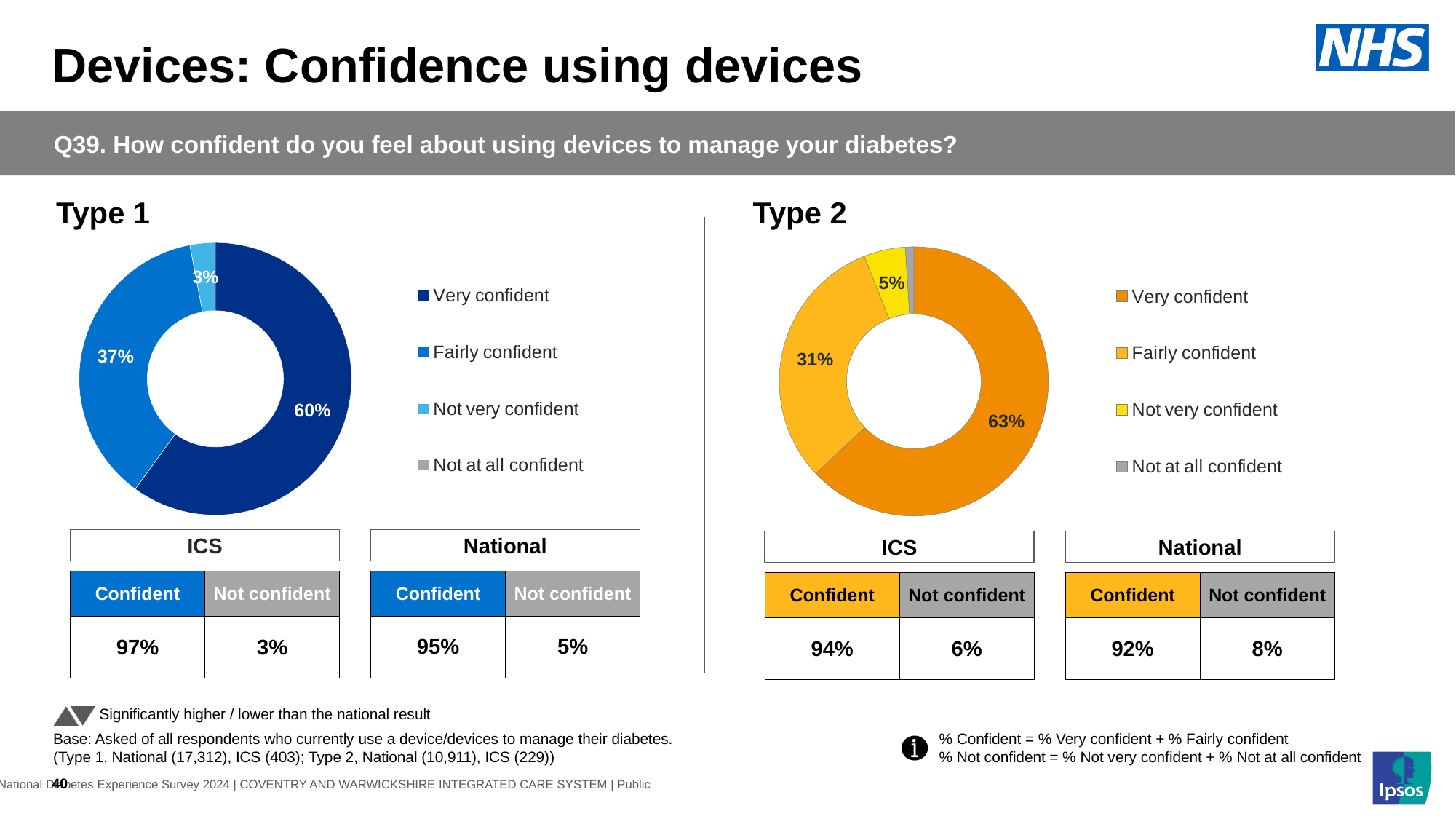
In the Type 2 chart, which category has the largest share? Very confident How many entries does the legend of the Type 2 chart list? 4 In the Type 2 chart, what percentage of respondents are not very confident? 5% What kind of chart is used for Type 1? Donut chart In the Type 1 chart, what is the difference between the very confident and fairly confident shares? 23% Is the very confident share larger in the Type 1 chart or the Type 2 chart? Type 2 In the Type 1 chart, what percentage of respondents are very confident? 60% In the Type 1 chart, what percentage of respondents are fairly confident? 37% In the Type 1 chart, what percentage of respondents are not very confident? 3% In the Type 2 chart, what percentage of respondents are very confident? 63% In the Type 2 chart, what percentage of respondents are fairly confident? 31% In the Type 1 chart, which category has the largest share? Very confident